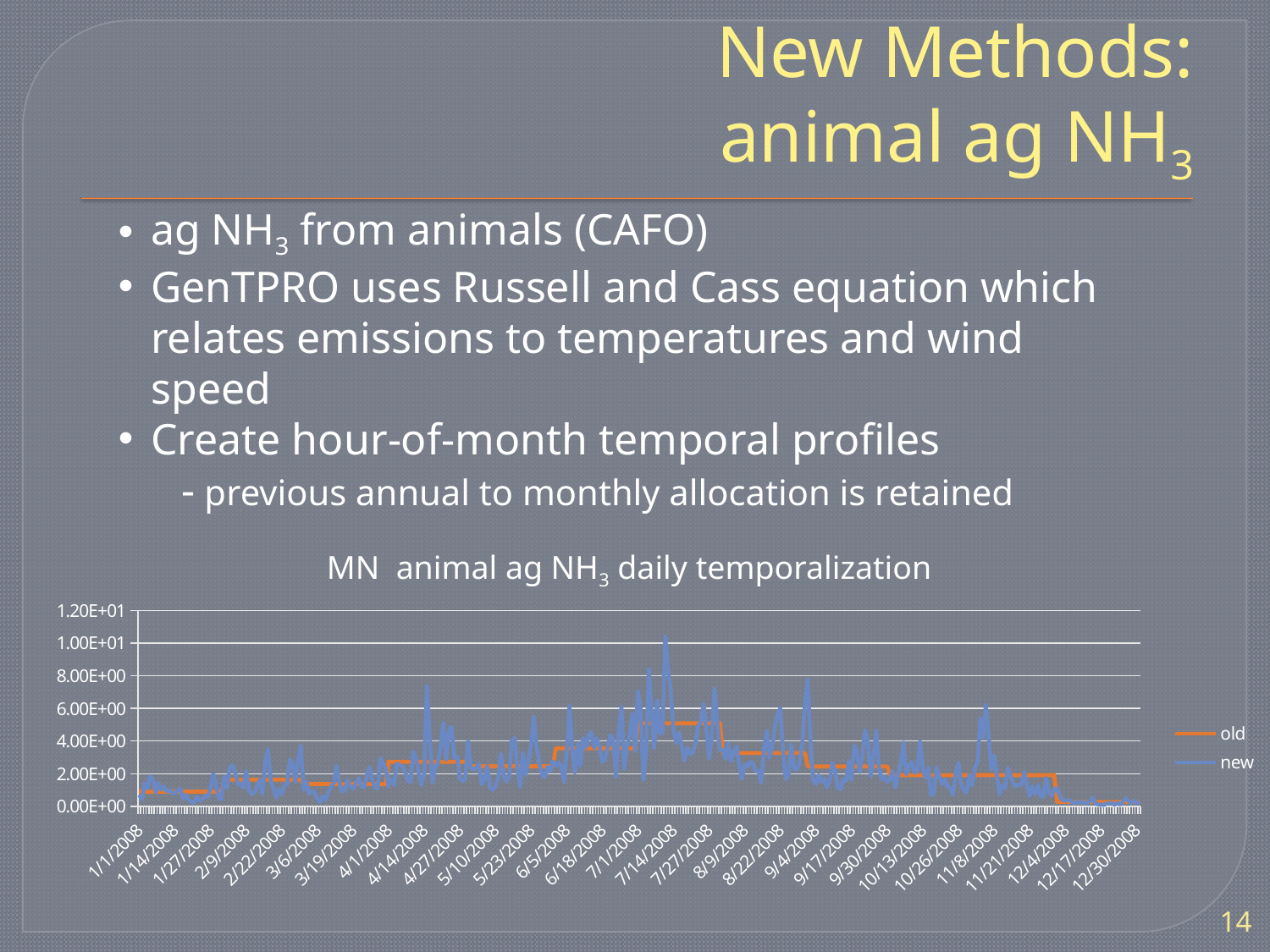
Is the value of the 'old' series in late December 2008 greater or less than 2.00E+00? less What kind of chart is shown on the slide? line chart What is the title of the chart? MN animal ag NH3 daily temporalization Is the value of the 'old' series in July 2008 greater or less than 4.00E+00? greater What is the first date label shown on the chart's horizontal axis? 1/1/2008 How many series does the legend of the chart list? 2 What is the highest value shown on the chart's vertical axis? 1.20E+01 Is the peak value of the 'new' series in mid-July 2008 greater or less than 8.00E+00? greater Which series reaches the higher peak value on the chart, 'old' or 'new'? new